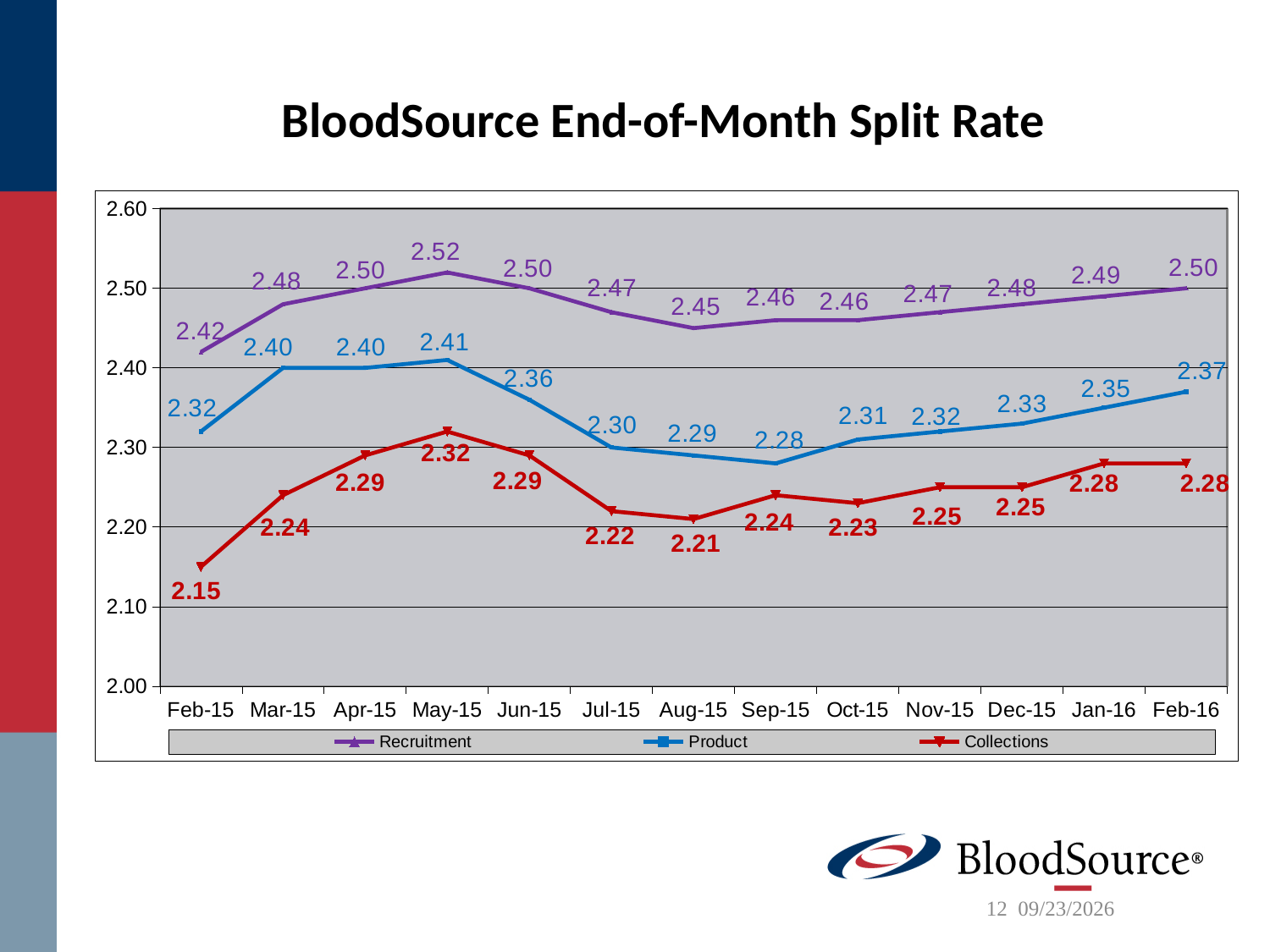
What is the Product value for Aug-15? 2.29 Which is larger, the Product value in Mar-15 or the Product value in Feb-16? Mar-15 In which month is the Recruitment series at its highest? May-15 Is the Collections value for Aug-15 greater or less than 2.30? less What is the difference between the Recruitment and Collections values in Feb-16? 0.22 What is the title of the chart? BloodSource End-of-Month Split Rate How many series does the legend list? 3 In which month is the Collections series at its lowest? Feb-15 What is the Recruitment value for May-15? 2.52 What type of chart is shown on the slide? Line chart How many months are plotted along the x axis? 13 What is the Collections value for Feb-15? 2.15